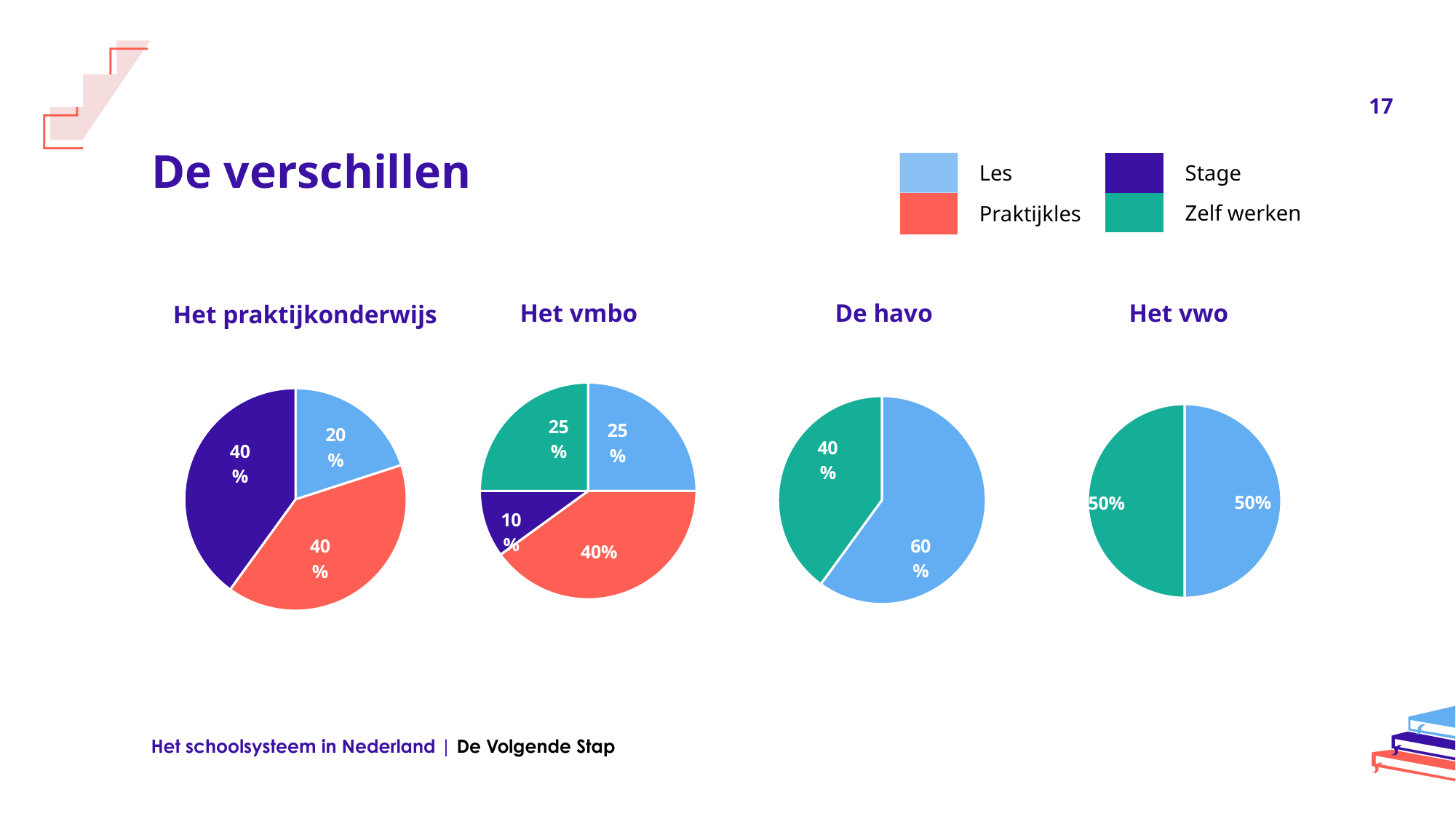
In the 'De havo' chart, what is the difference between the Les and Zelf werken shares? 20% How many slices does the 'Het vmbo' chart have? 4 How many categories does the shared legend list? 4 In the 'Het vmbo' chart, which is larger, Les or Stage? Les In the 'De havo' chart, what share is Zelf werken? 40% How many slices does the 'De havo' chart have? 2 In the 'Het vmbo' chart, what share is Stage? 10% In the 'Het praktijkonderwijs' chart, which category has the smallest slice? Les In the 'Het vwo' chart, what share is Les? 50% What kind of chart is used for 'Het vwo'? Pie chart In the 'Het praktijkonderwijs' chart, what share is Les? 20% In the 'Het vmbo' chart, which category has the largest slice? Praktijkles